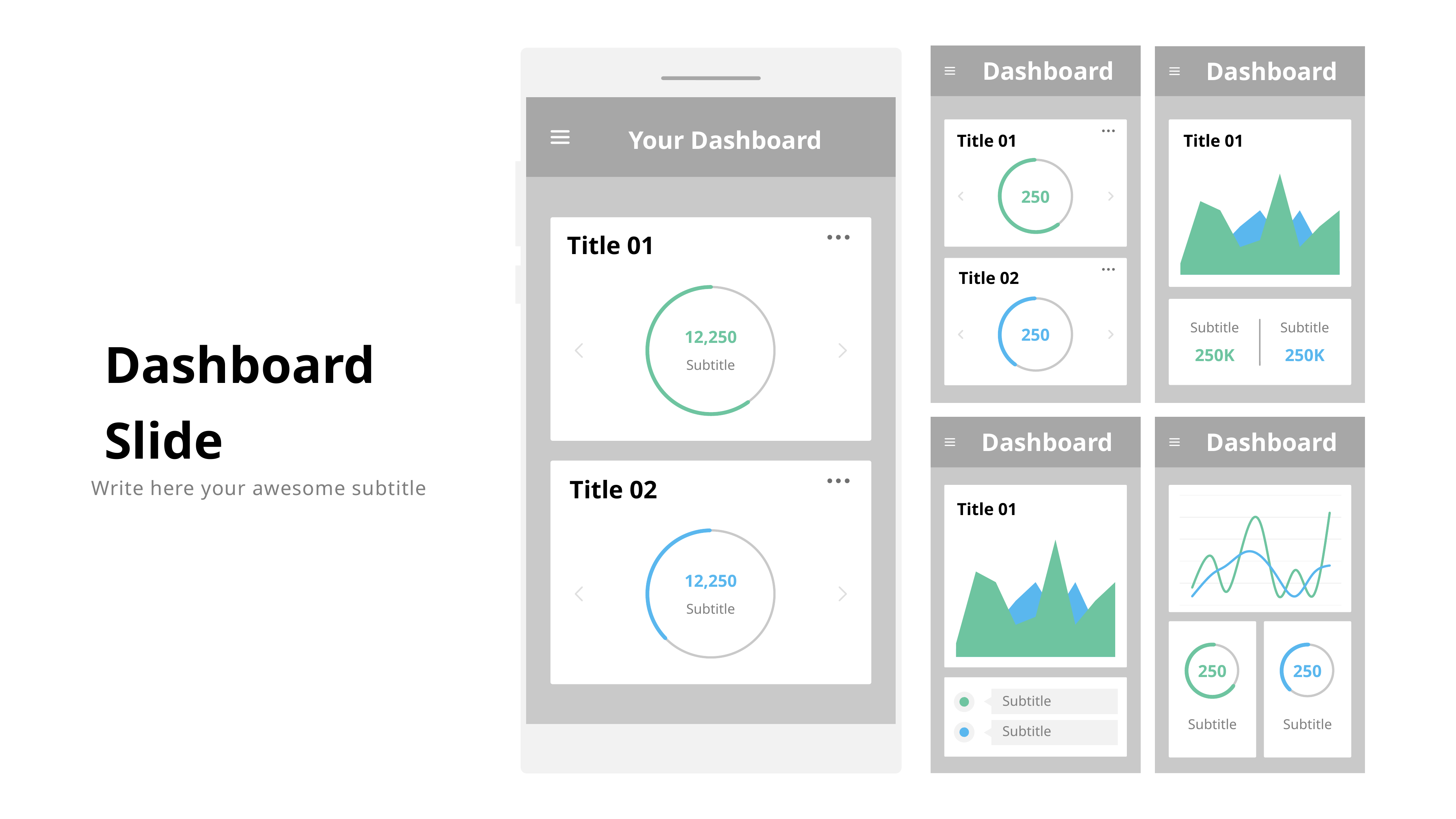
On the top-left small 'Dashboard' panel, what value is shown in the Title 01 ring chart? 250 What kind of chart is shown under Title 01 on the top-right small 'Dashboard' panel? Area chart On the top-left small 'Dashboard' panel, what value is shown in the Title 02 ring chart? 250 How many entries does the legend list below the Title 01 area chart on the bottom-left small 'Dashboard' panel? 2 On the top-right small 'Dashboard' panel, what green value is printed below the Title 01 area chart? 250K What kind of chart is shown at the top of the bottom-right small 'Dashboard' panel? Line chart On the bottom-right small 'Dashboard' panel, what value is shown in the green ring chart? 250 On the large 'Your Dashboard' phone mockup, what value is shown in the centre of the Title 02 ring chart? 12,250 How many lines are plotted in the line chart on the bottom-right small 'Dashboard' panel? 2 On the large 'Your Dashboard' phone mockup, what value is shown in the centre of the Title 01 ring chart? 12,250 On the top-right small 'Dashboard' panel, what blue value is printed below the Title 01 area chart? 250K On the large 'Your Dashboard' phone mockup, what colour is the Title 02 ring chart? Blue